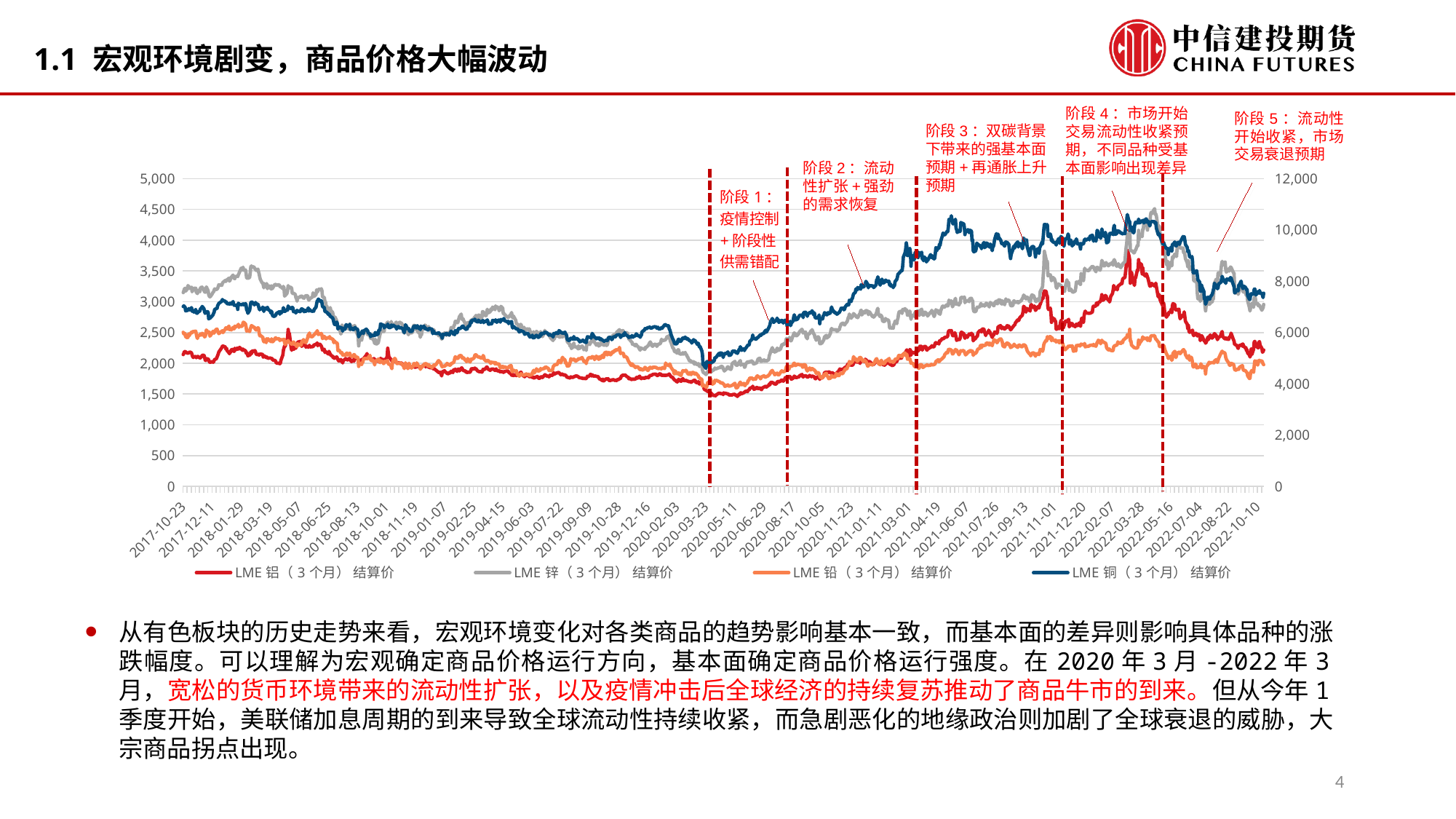
Does LME 锌（3 个月）结算价 rise or fall between 2022-03-28 and 2022-10-10? fall How many series does the chart legend list? 4 How many stages (阶段) are annotated on the chart? 5 What is the maximum value shown on the right vertical axis of the chart? 12,000 Which series is drawn in red in the chart? LME 铝（3 个月）结算价 What is the first date label on the x axis of the chart? 2017-10-23 Is the value of LME 铝（3 个月）结算价 around 2020-03-23 greater or less than 2,000 on the left axis? less Does LME 铝（3 个月）结算价 rise or fall between 2020-03-23 and 2022-03-28? rise What is the last date label on the x axis of the chart? 2022-10-10 Is the value of LME 锌（3 个月）结算价 around 2018-01-29 greater or less than 3,000 on the left axis? greater What is the maximum value shown on the left vertical axis of the chart? 5,000 What kind of chart is shown on the slide? line chart